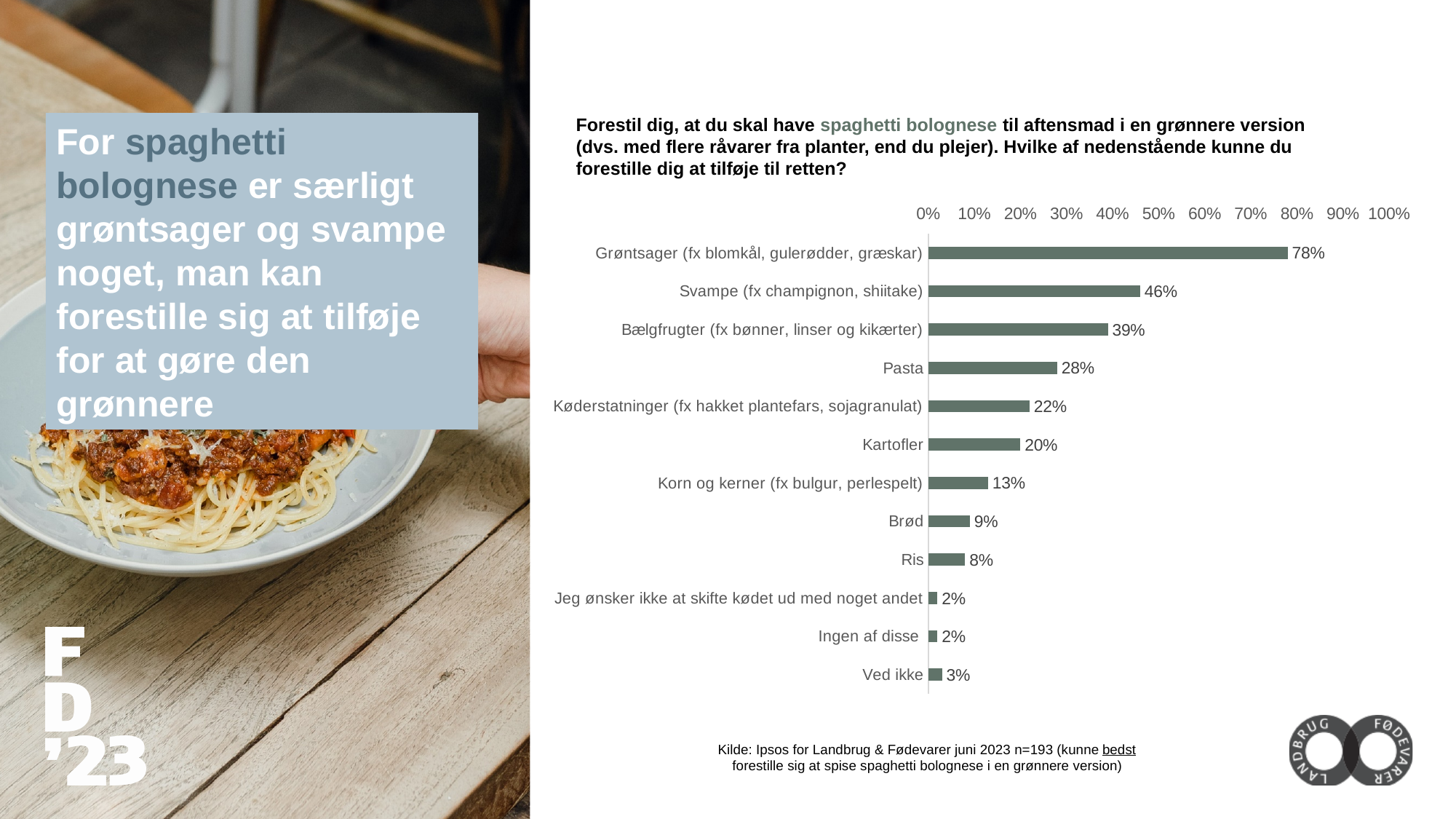
Which is larger, the value for Bælgfrugter (fx bønner, linser og kikærter) or the value for Pasta? Bælgfrugter (fx bønner, linser og kikærter) Which is larger, the value for Brød or the value for Ris? Brød What kind of chart is shown on the slide? Bar chart What is the value for Kartofler? 20% What is the value for Ved ikke? 3% What is the value for Køderstatninger (fx hakket plantefars, sojagranulat)? 22% What is the difference between the values for Pasta and Kartofler? 8 percentage points How many categories are shown in the chart? 12 Which category has the highest value? Grøntsager (fx blomkål, gulerødder, græskar) What is the difference between the values for Grøntsager and Svampe? 32 percentage points What is the value for Svampe (fx champignon, shiitake)? 46% What percentage of respondents could imagine adding Grøntsager (fx blomkål, gulerødder, græskar) to the dish? 78%